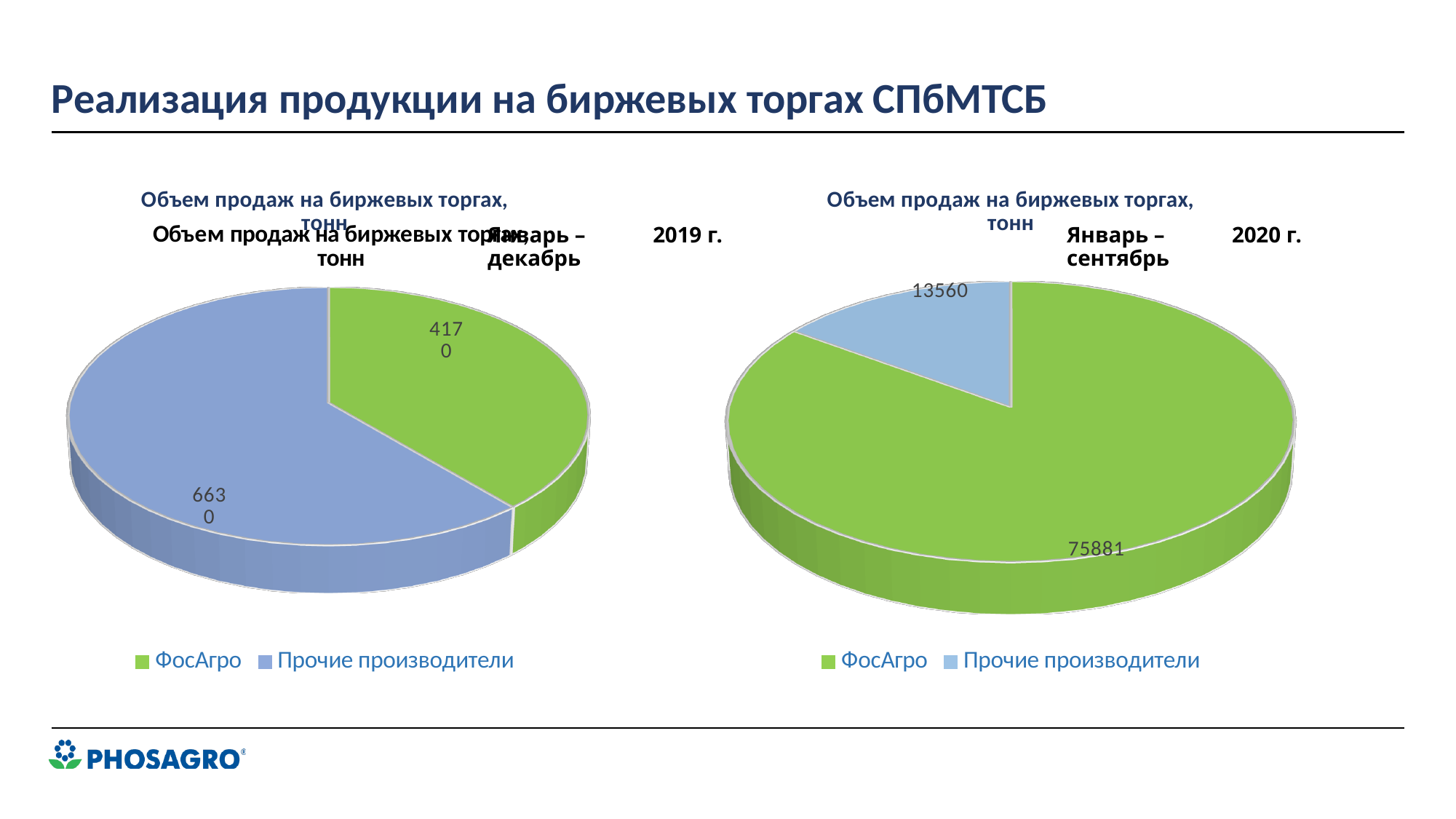
How many categories does the legend of the 2020 pie chart (right) list? 2 In the 2019 pie chart (left), what is the value for ФосАгро? 4170 In the 2019 pie chart (left), which category has the largest slice? Прочие производители In the 2020 pie chart (right), what is the value for ФосАгро? 75881 In the 2019 pie chart (left), what is the value for Прочие производители? 6630 In the 2020 pie chart (right), what is the difference between the ФосАгро value and the Прочие производители value? 62321 In the 2019 pie chart (left), what is the difference between the Прочие производители value and the ФосАгро value? 2460 What type of chart is used on this slide? Pie chart In the 2019 pie chart (left), which is larger: ФосАгро or Прочие производители? Прочие производители In the 2020 pie chart (right), what is the value for Прочие производители? 13560 In the 2020 pie chart (right), what colour is the ФосАгро slice? Green In the 2020 pie chart (right), which category has the smallest slice? Прочие производители